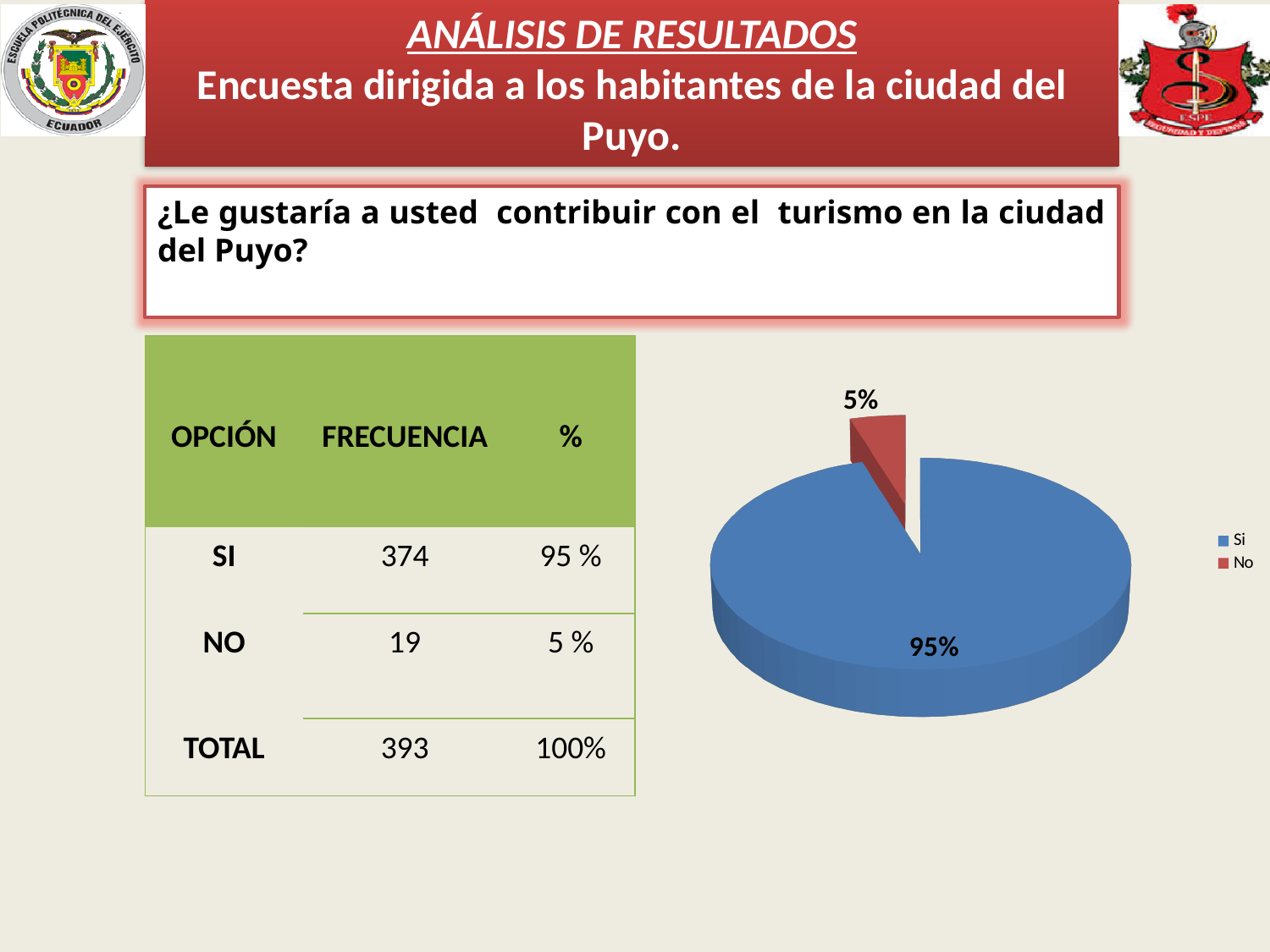
What colour is the "No" slice in the pie chart? red What share of the pie does the "Si" slice represent? 95% Which is larger in the pie chart, the "Si" slice or the "No" slice? Si How many slices does the pie chart have? 2 What share of the pie does the "No" slice represent? 5% Which slice of the pie chart is the largest? Si Which slice of the pie chart is the smallest? No What is the difference in percentage points between the "Si" slice and the "No" slice? 90% How many entries does the legend of the pie chart list? 2 What kind of chart is shown on the slide? pie chart What colour is the "Si" slice in the pie chart? blue